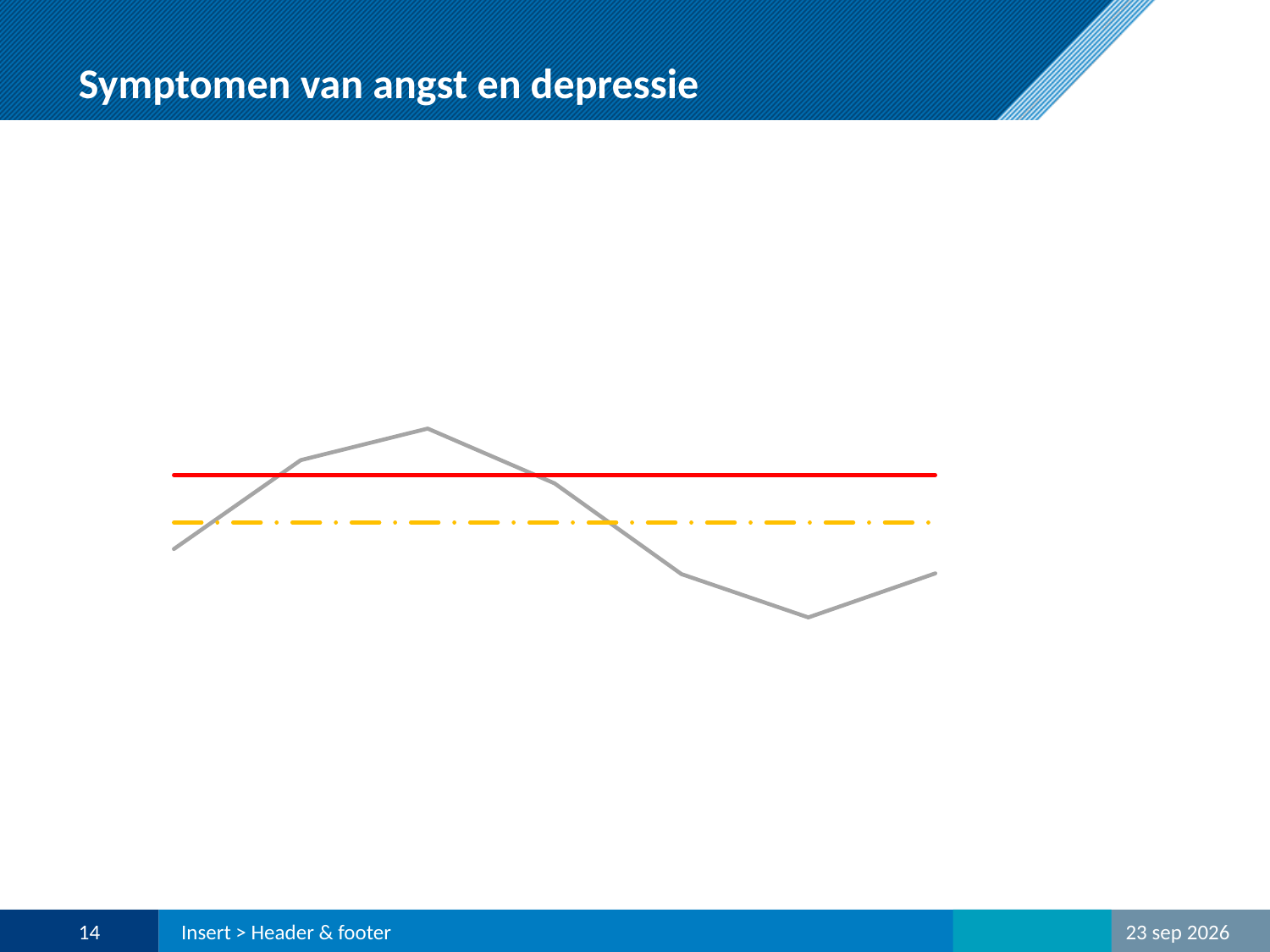
How many lines are plotted on the chart? 3 Does the grey line rise or fall between its first point and its highest point? rise Does the grey line end above or below the dashed yellow line? below What colour is the dashed horizontal line on the chart? yellow Which of the two horizontal lines is higher on the chart, the solid red line or the dashed yellow line? the solid red line What is the title of the slide containing the chart? Symptomen van angst en depressie What kind of chart is shown on the slide? line chart